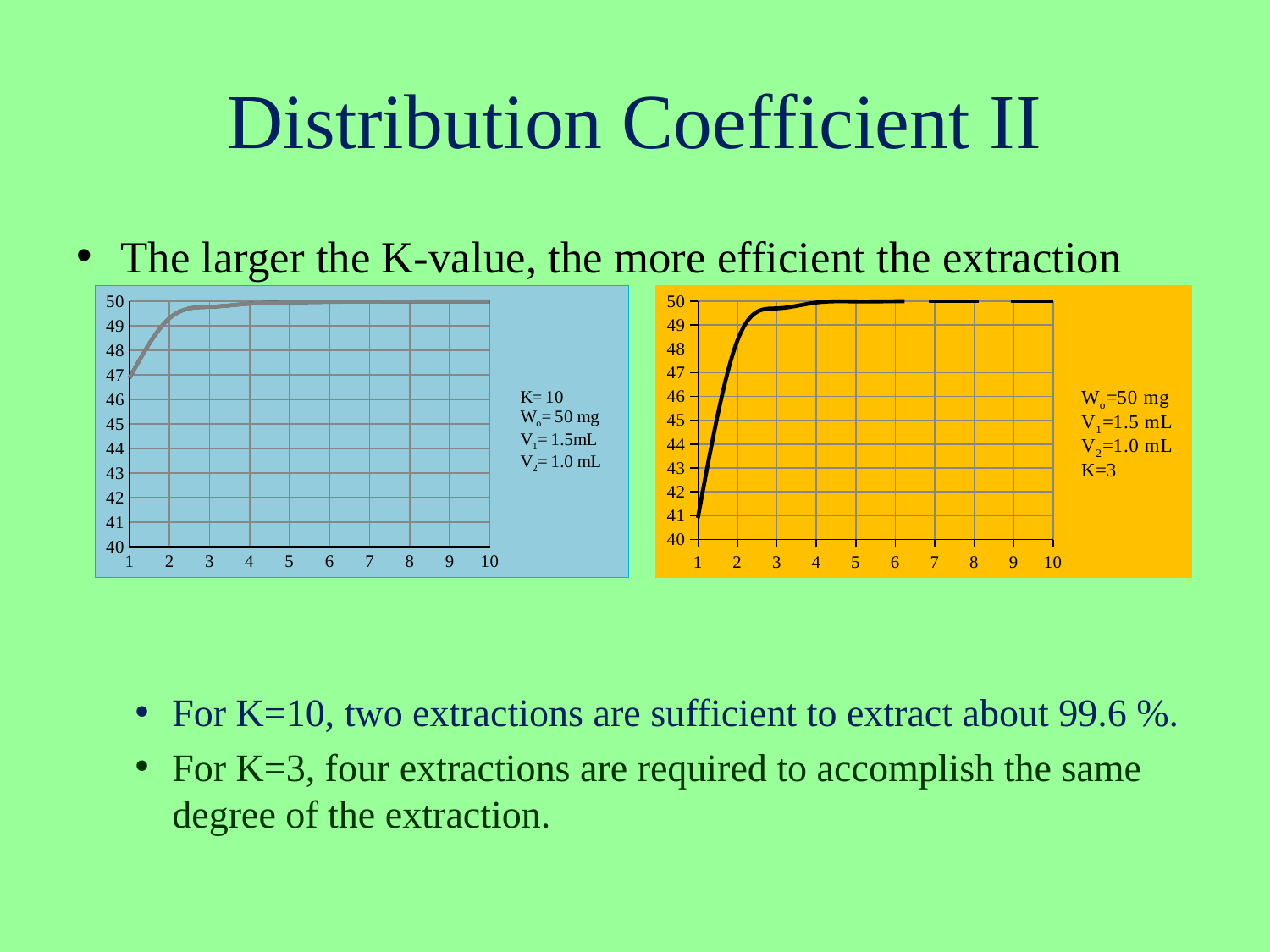
In the left chart, do the values rise or fall as the x axis goes from 1 to 10? rise In the right chart, is the value at x = 2 greater or less than 47? greater In the right chart, is the value at x = 1 greater or less than 42? less What kind of chart is the left chart on the blue background? line chart In the left chart, is the value at x = 1 greater or less than 48? less In the right chart, do the values rise or fall as the x axis goes from 1 to 10? rise What K value is annotated next to the right chart? K=3 At x = 1, which chart shows the larger value, the left chart or the right chart? the left chart What kind of chart is the right chart on the orange background? line chart How many points are marked along the x axis of the right chart? 10 How many points are marked along the x axis of the left chart? 10